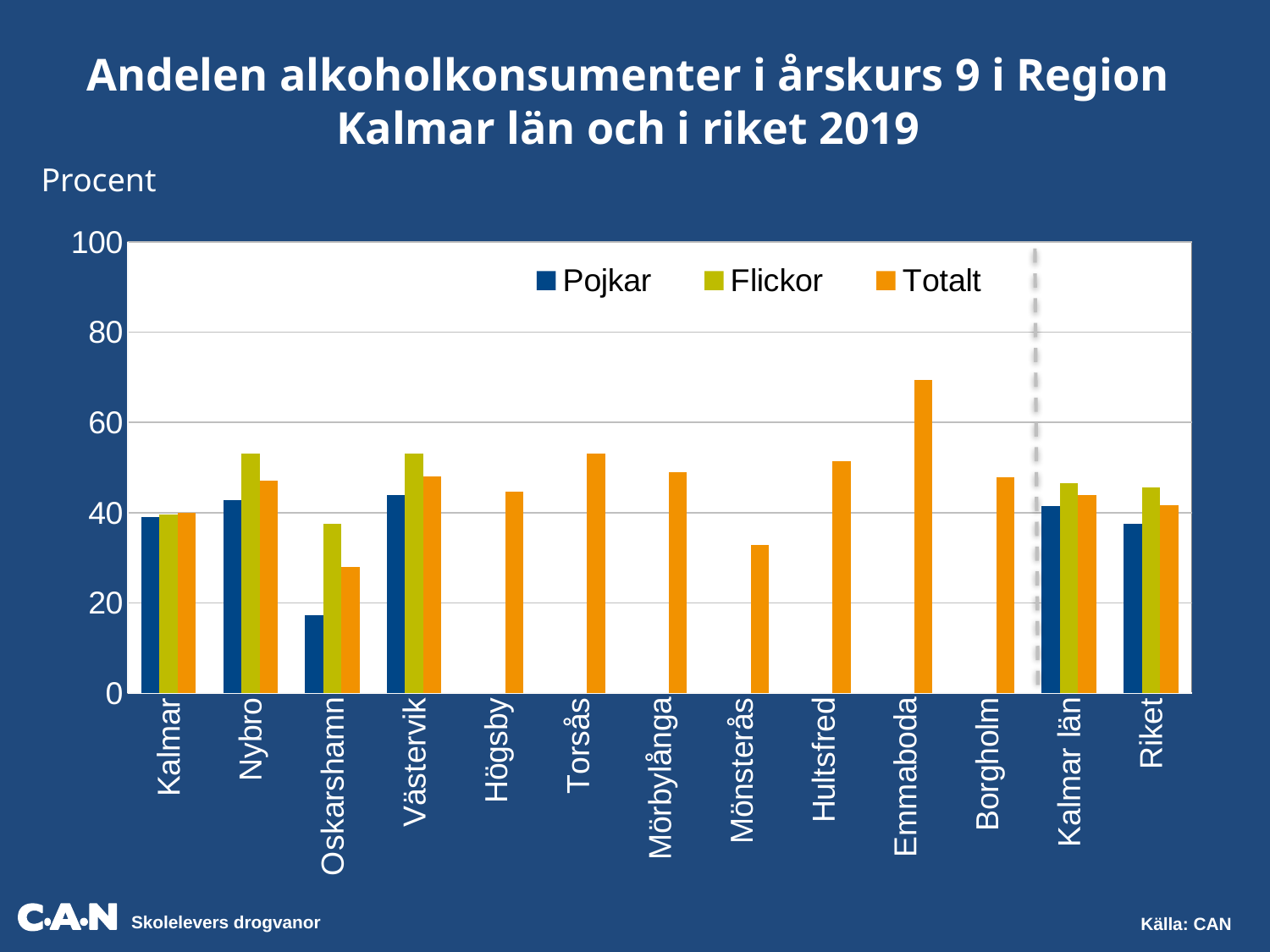
Which category has the highest Totalt value? Emmaboda What label is shown above the y axis? Procent Which category has the lowest Totalt value? Oskarshamn For Oskarshamn, which is larger: the Pojkar value or the Flickor value? Flickor How many series does the legend list? 3 Is the Pojkar value for Oskarshamn greater or less than 20? less How many categories are shown along the x axis? 13 Is the Totalt value for Emmaboda greater or less than 60? greater Is the Totalt value for Torsås greater or less than 40? greater What kind of chart is shown on the slide? Bar chart Which category has the lowest Pojkar value? Oskarshamn